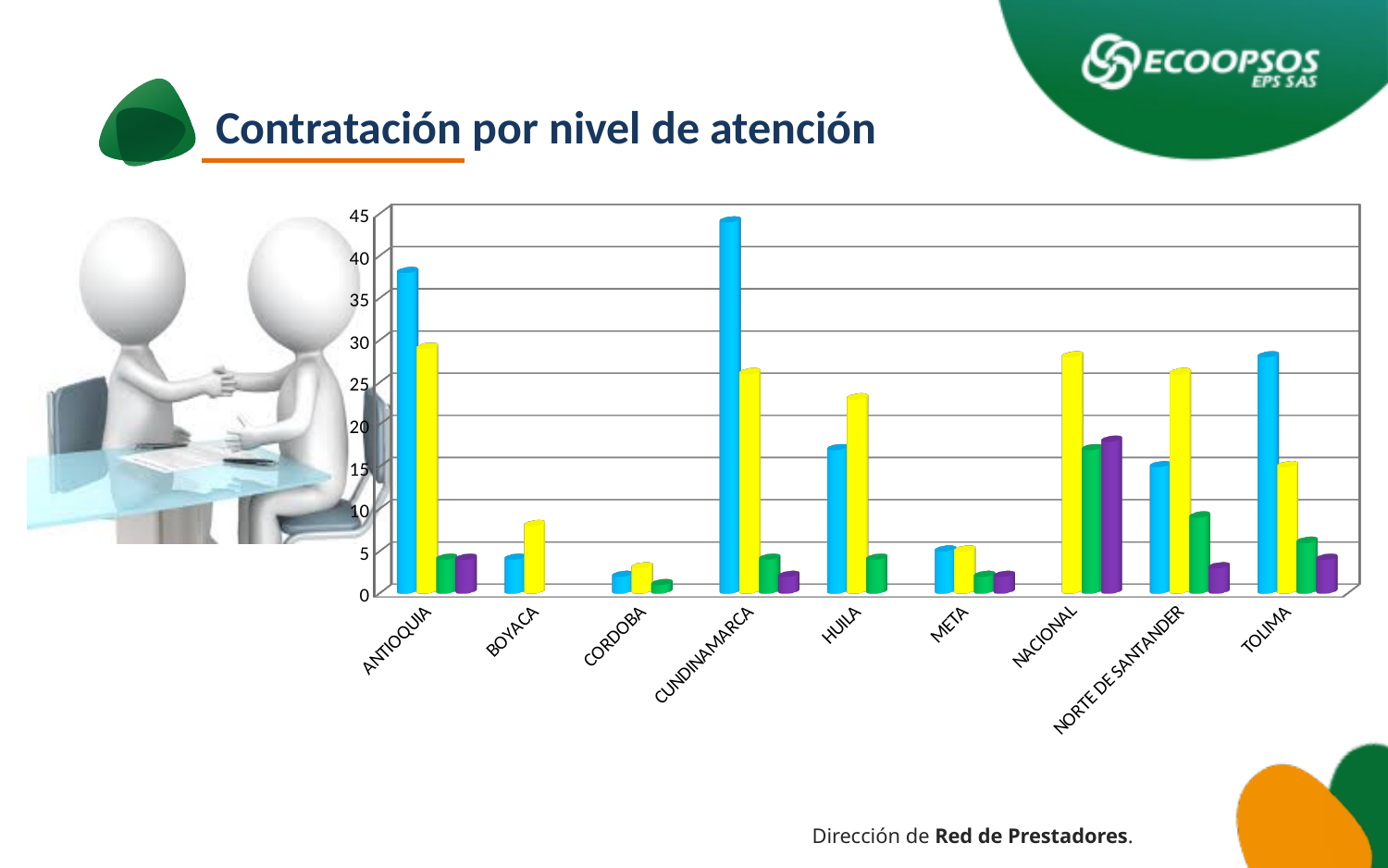
Is the blue bar for ANTIOQUIA greater or less than 35? greater Which category has the tallest blue bar? CUNDINAMARCA How many categories are shown on the x axis of the chart? 9 Which category has the tallest green bar? NACIONAL Is the yellow bar for HUILA greater or less than 20? greater What kind of chart is shown on the slide? bar chart What is the title of the slide containing the chart? Contratación por nivel de atención Which category has the tallest purple bar? NACIONAL Which has the taller blue bar, ANTIOQUIA or TOLIMA? ANTIOQUIA Is the yellow bar for BOYACA greater or less than 10? less Which has the taller yellow bar, HUILA or META? HUILA